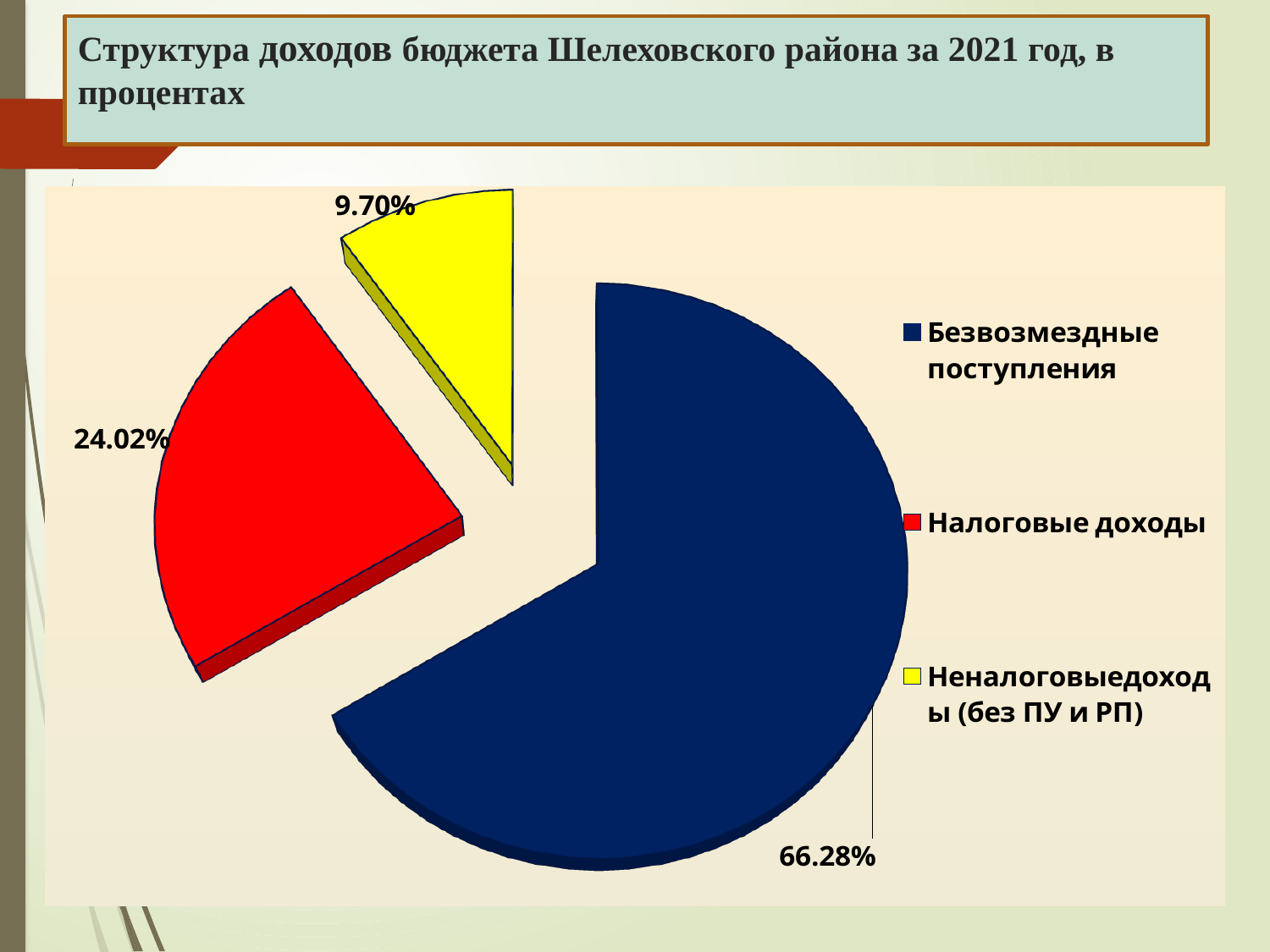
Which is larger, the slice for Налоговые доходы or the slice for Неналоговые доходы (без ПУ и РП)? Налоговые доходы What share of the pie is labelled for Налоговые доходы? 24.02% Which category has the largest slice of the pie? Безвозмездные поступления What is the difference in percentage points between Налоговые доходы and Неналоговые доходы (без ПУ и РП)? 14.32 Which category has the smallest slice of the pie? Неналоговые доходы (без ПУ и РП) How many slices does the pie chart have? 3 What is the title of the slide? Структура доходов бюджета Шелеховского района за 2021 год, в процентах What is the difference in percentage points between Безвозмездные поступления and Налоговые доходы? 42.26 What kind of chart is shown on the slide? Pie chart What share of the pie is labelled for Неналоговые доходы (без ПУ и РП)? 9.70% What colour is the slice for Налоговые доходы? Red What share of the pie is labelled for Безвозмездные поступления? 66.28%